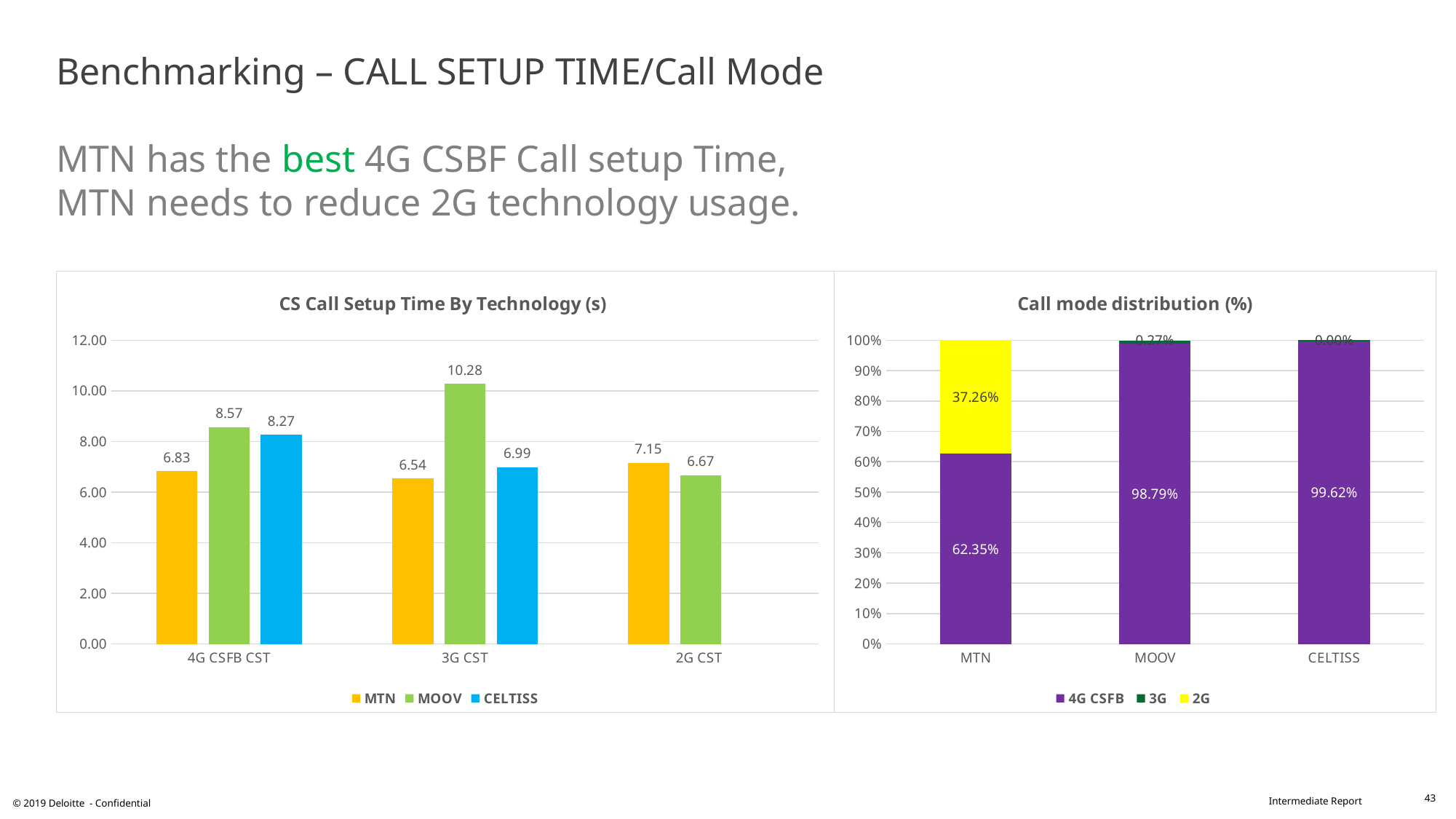
In the 'CS Call Setup Time By Technology (s)' chart, which is larger at 2G CST: MTN or MOOV? MTN In the 'CS Call Setup Time By Technology (s)' chart, which operator has the lowest value at 3G CST? MTN How many operators are shown on the x axis of the 'Call mode distribution (%)' chart? 3 In the 'CS Call Setup Time By Technology (s)' chart, what is the difference between MOOV and CELTISS at 4G CSFB CST? 0.30 How many series does the legend of the 'CS Call Setup Time By Technology (s)' chart list? 3 In the 'Call mode distribution (%)' chart, what is the 2G share for MTN? 37.26% In the 'Call mode distribution (%)' chart, which operator has the lowest 4G CSFB share? MTN In the 'CS Call Setup Time By Technology (s)' chart, what is the value for MTN at 4G CSFB CST? 6.83 In the 'Call mode distribution (%)' chart, what is the 4G CSFB share for MOOV? 98.79% What kind of chart is 'Call mode distribution (%)'? Stacked bar chart In the 'CS Call Setup Time By Technology (s)' chart, what is the value for MOOV at 3G CST? 10.28 In the 'CS Call Setup Time By Technology (s)' chart, which operator has the highest value at 4G CSFB CST? MOOV